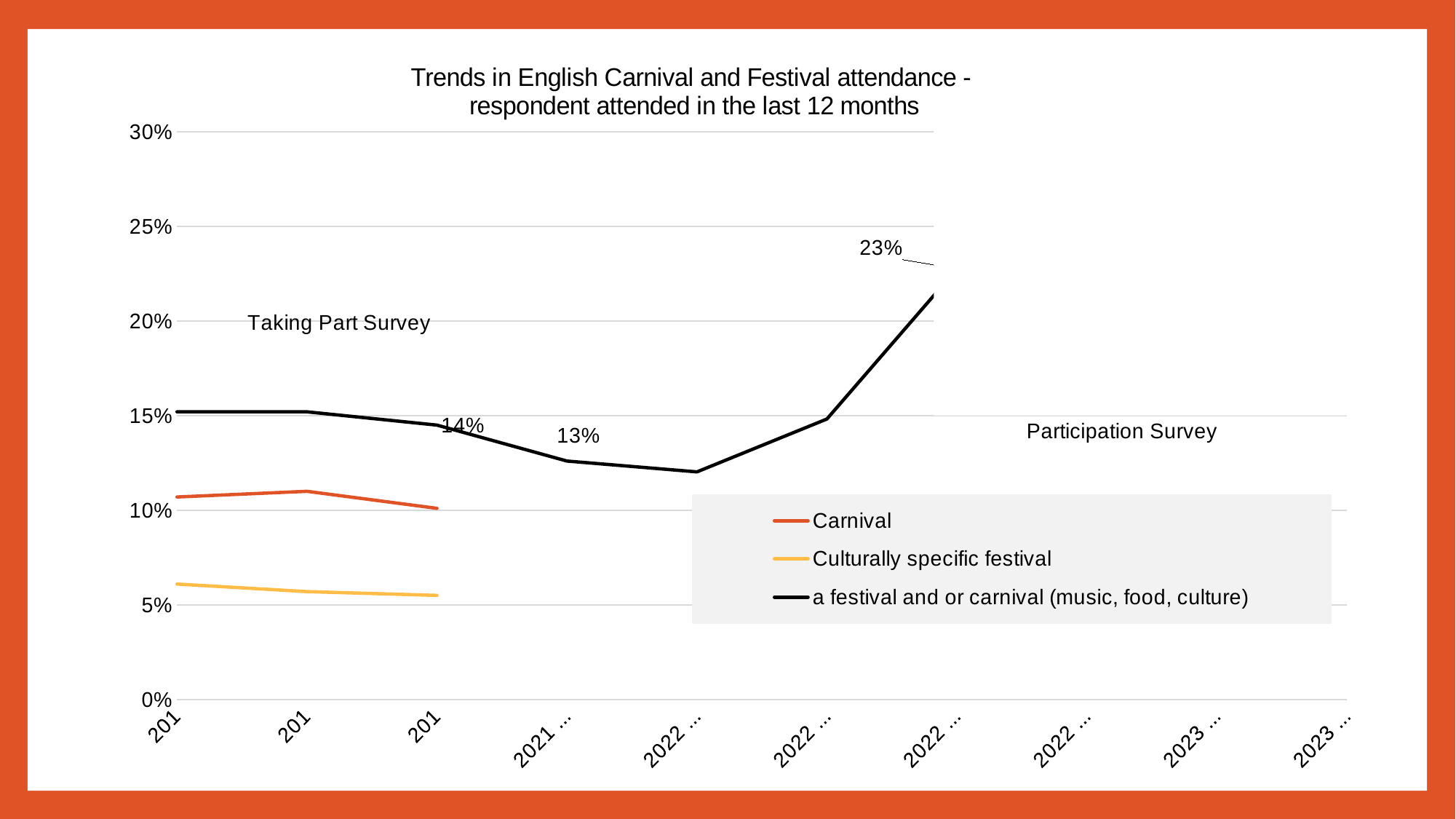
Which series has higher values, Carnival or Culturally specific festival? Carnival What is the highest data label printed on the chart? 23% Is the highest point of the 'a festival and or carnival (music, food, culture)' line greater or less than 20%? greater How many series does the legend list? 3 Which series has the lowest values throughout the chart? Culturally specific festival Does the Culturally specific festival line rise or fall from left to right? fall What type of chart is shown on the slide? Line chart Which series has the highest values throughout the chart? a festival and or carnival (music, food, culture) Which series is drawn with the black line? a festival and or carnival (music, food, culture) What is the title of the chart? Trends in English Carnival and Festival attendance - respondent attended in the last 12 months What is the lowest data label printed on the chart? 13% Are the values of the Culturally specific festival line greater or less than 10%? less